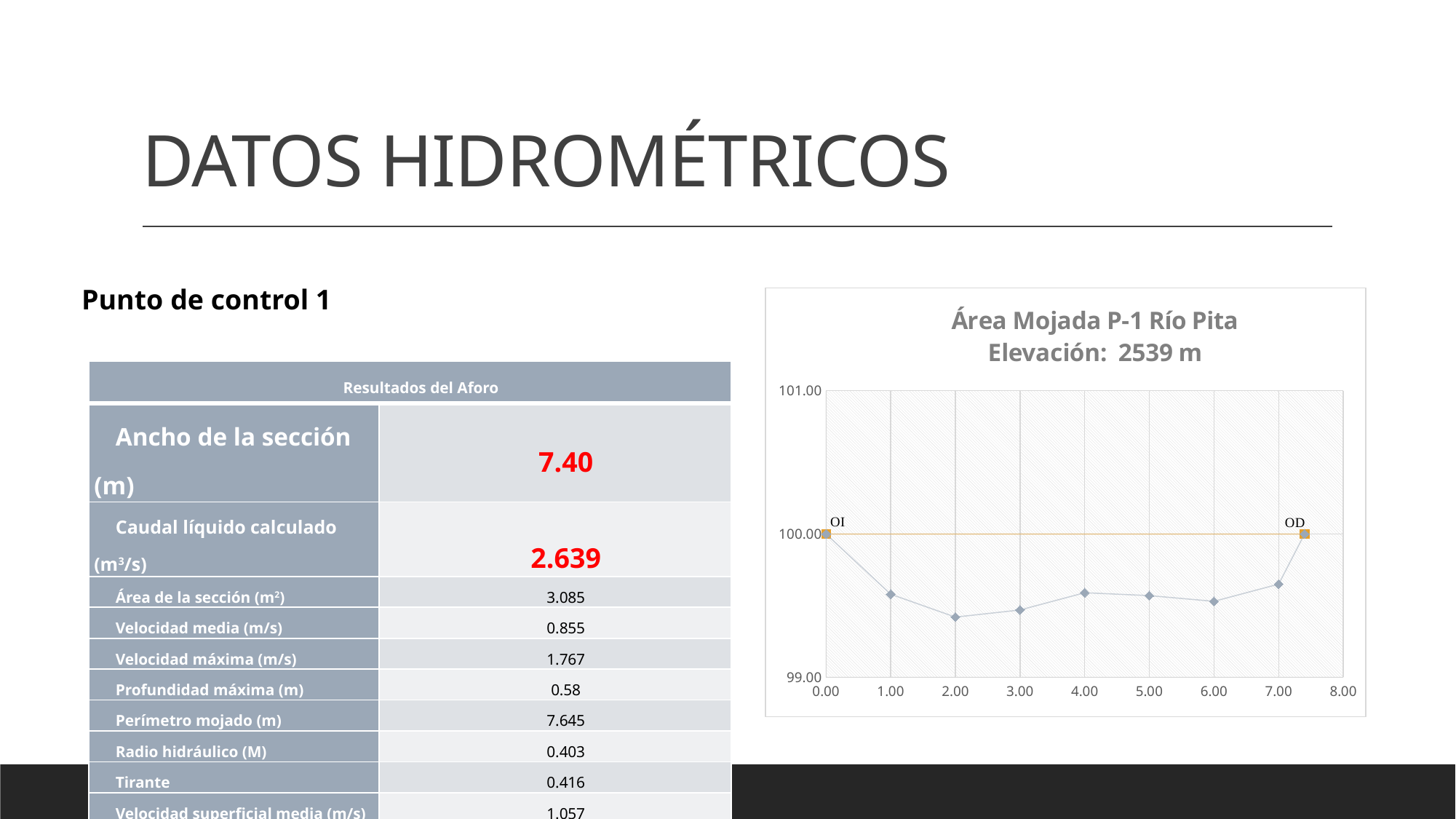
Is the value at x = 7.00 greater or less than 100.00? less Is the value at x = 2.00 greater or less than 100.00? less What kind of chart is shown on the slide? line chart Which point is higher, the one at x = 1.00 or the one at x = 2.00? x = 1.00 What value does the point labelled OI have on the y axis? 100.00 What value does the point labelled OD have on the y axis? 100.00 What is the title of the chart on the slide? Área Mojada P-1 Río Pita Elevación: 2539 m What is the highest value shown on the chart's y axis? 101.00 Do the values rise or fall from x = 6.00 to the point labelled OD? rise Do the values rise or fall from x = 0.00 to x = 2.00? fall At which x value is the lowest point on the chart? 2.00